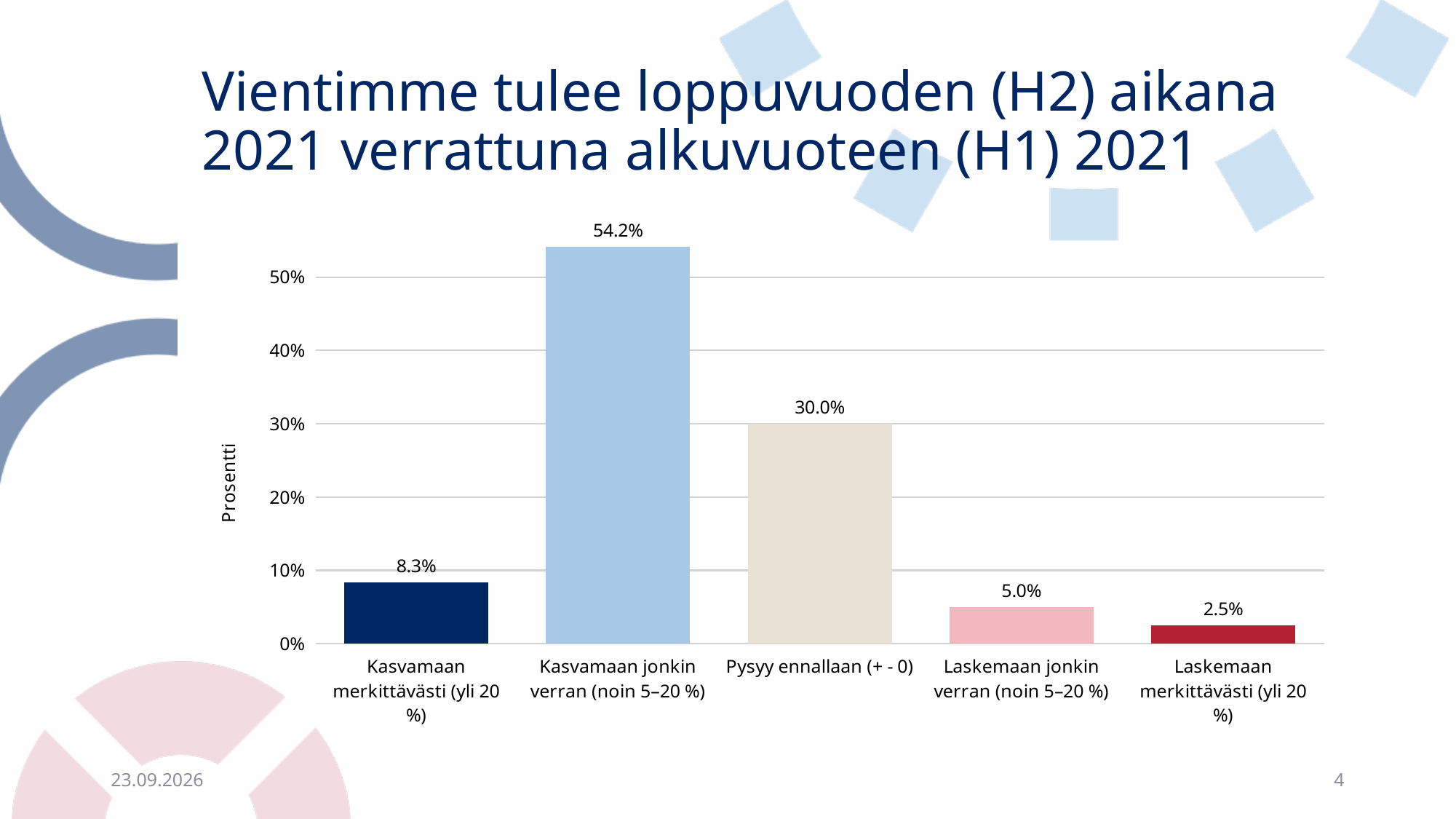
Which category has the highest value? Kasvamaan jonkin verran (noin 5–20 %) What kind of chart is shown on the slide? bar chart What is the label of the vertical axis? Prosentti Is the value for "Pysyy ennallaan (+ - 0)" greater or less than 20%? greater What is the value for "Laskemaan merkittävästi (yli 20 %)"? 2.5% How many categories are shown in the chart? 5 What is the value for "Kasvamaan merkittävästi (yli 20 %)"? 8.3% What is the value for "Kasvamaan jonkin verran (noin 5–20 %)"? 54.2% What is the value for "Pysyy ennallaan (+ - 0)"? 30.0% What is the difference between the values for "Kasvamaan jonkin verran (noin 5–20 %)" and "Pysyy ennallaan (+ - 0)"? 24.2% Which is larger: the value for "Kasvamaan merkittävästi (yli 20 %)" or "Laskemaan jonkin verran (noin 5–20 %)"? Kasvamaan merkittävästi (yli 20 %) Which category has the lowest value? Laskemaan merkittävästi (yli 20 %)